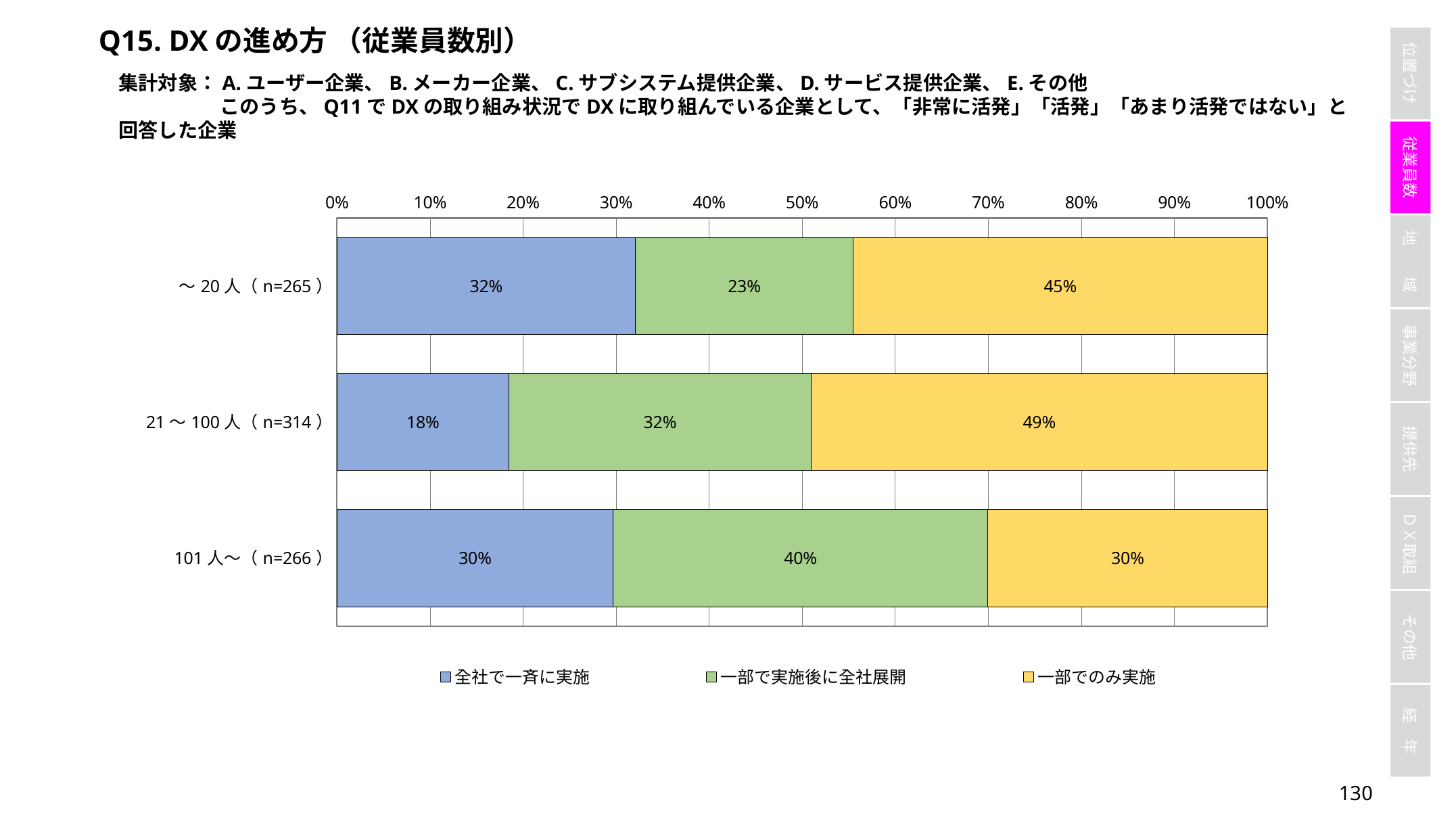
Which employee-size category has the highest value for 一部でのみ実施? 21～100人（n=314） What colour represents 一部でのみ実施 in the chart? Yellow How many series does the legend list? 3 What is the value of 一部でのみ実施 for 101人～（n=266）? 30% What kind of chart is shown on the slide? Stacked bar chart What is the difference between the 一部で実施後に全社展開 values for 101人～（n=266） and ～20人（n=265）? 17% What is the value of 一部で実施後に全社展開 for 21～100人（n=314）? 32% Which employee-size category has the lowest value for 全社で一斉に実施? 21～100人（n=314） What is the value of 全社で一斉に実施 for ～20人（n=265）? 32% How many employee-size categories are shown in the chart? 3 Which is larger for 101人～（n=266）: 全社で一斉に実施 or 一部で実施後に全社展開? 一部で実施後に全社展開 What is the total of the stacked bar for 21～100人（n=314）? 99%